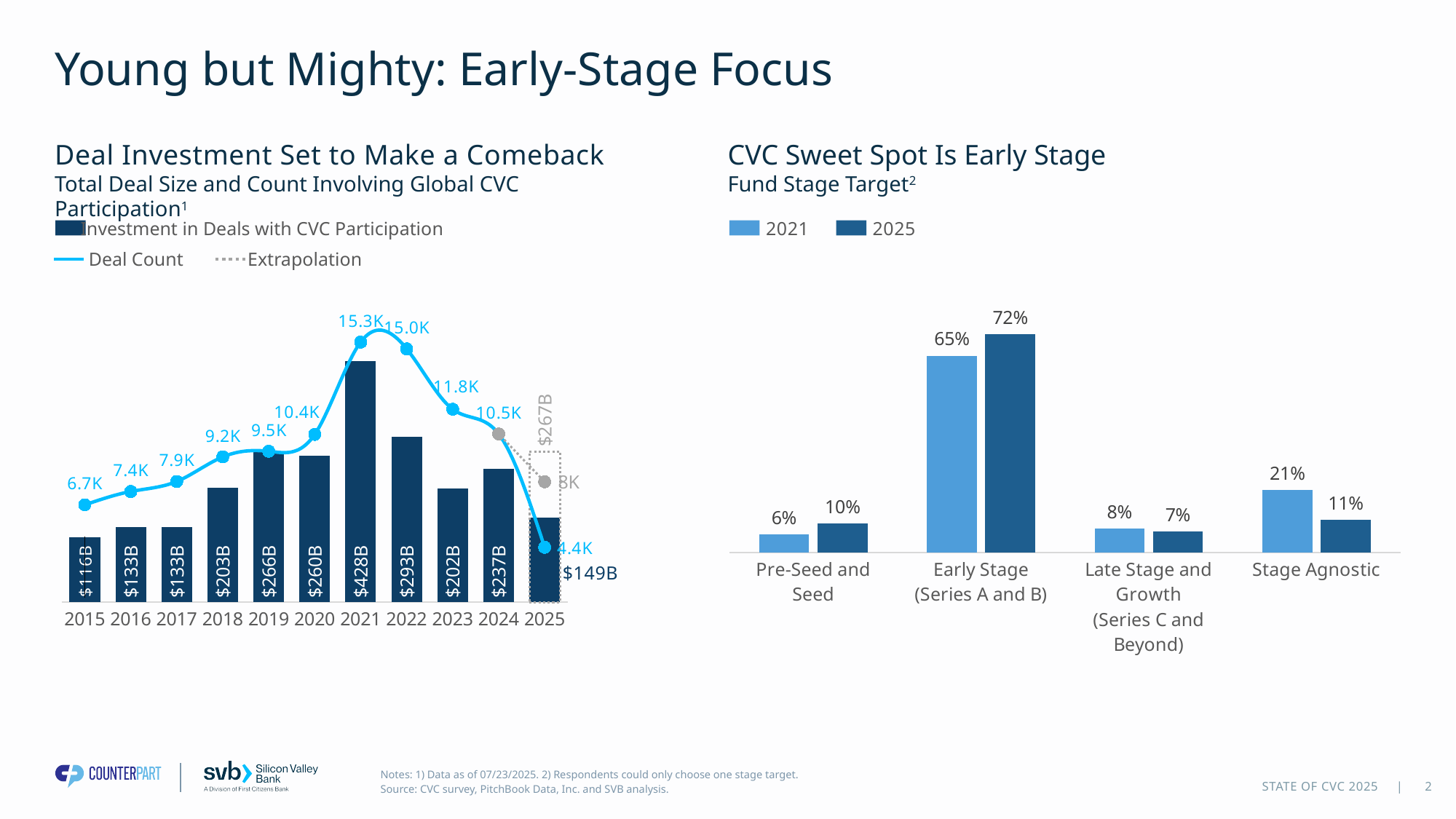
In the 'Deal Investment Set to Make a Comeback' chart, what is the difference between the investment in 2021 and in 2022? $135B In the 'CVC Sweet Spot Is Early Stage' chart, what share of respondents targeted Early Stage (Series A and B) in 2025? 72% In the 'CVC Sweet Spot Is Early Stage' chart, which stage had the highest value in 2021? Early Stage (Series A and B) In the 'Deal Investment Set to Make a Comeback' chart, what was the deal count in 2019? 9.5K In the 'CVC Sweet Spot Is Early Stage' chart, what share of respondents were Stage Agnostic in 2021? 21% In the 'Deal Investment Set to Make a Comeback' chart, did the deal count rise or fall from 2021 to 2025? Fall In the 'CVC Sweet Spot Is Early Stage' chart, which is larger for Pre-Seed and Seed: the 2021 value or the 2025 value? 2025 In the 'CVC Sweet Spot Is Early Stage' chart, how many series does the legend list? 2 In the 'Deal Investment Set to Make a Comeback' chart, which year had the highest investment in deals with CVC participation? 2021 In the 'Deal Investment Set to Make a Comeback' chart, which year had the lowest deal count? 2025 In the 'Deal Investment Set to Make a Comeback' chart, what was the investment in deals with CVC participation in 2021? $428B In the 'Deal Investment Set to Make a Comeback' chart, how many years are shown on the x axis? 11